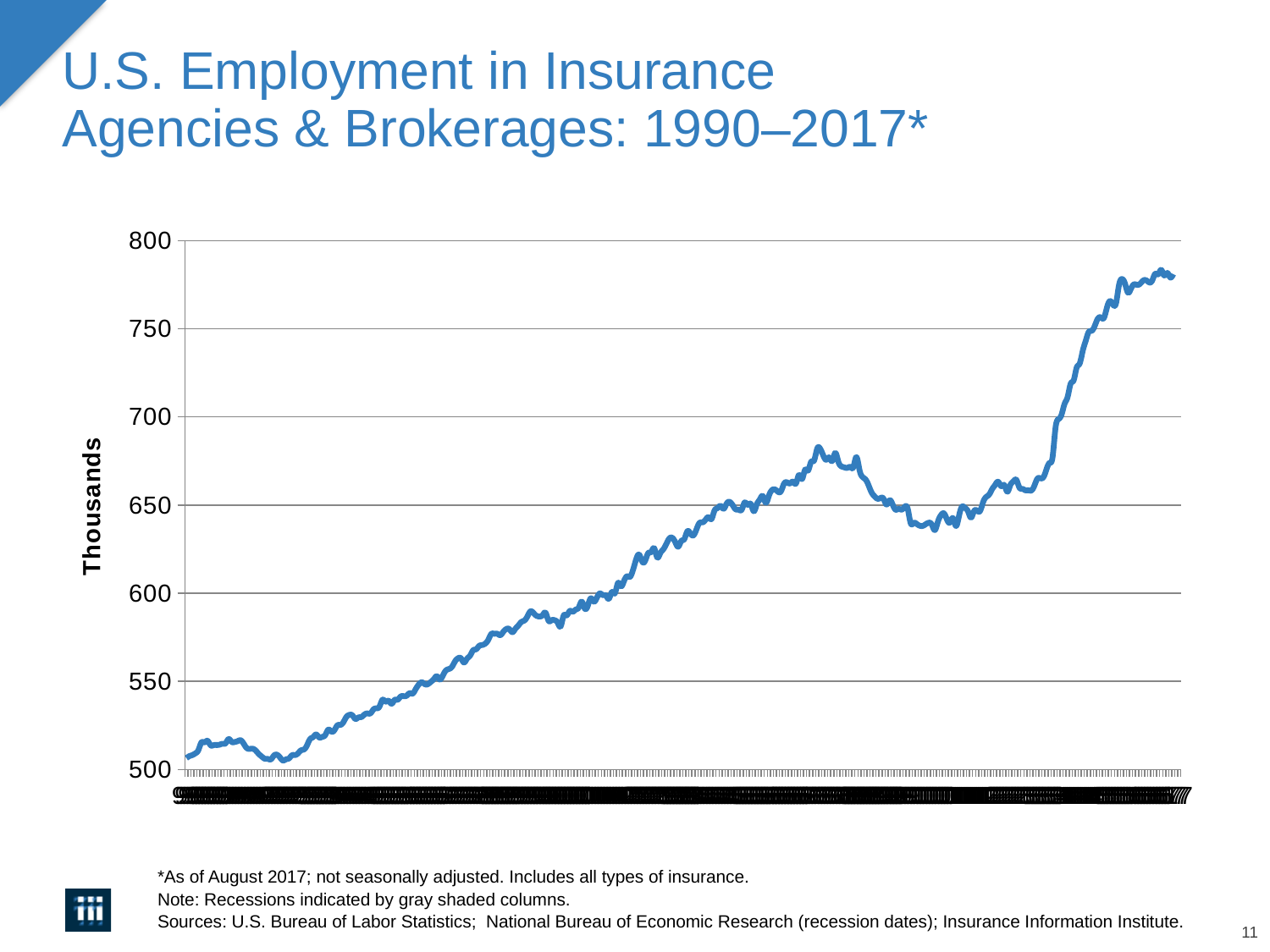
Is the highest value reached by the line greater or less than 750? greater Is the value at the rightmost (ending) point of the line greater or less than 750? greater What is the highest value shown on the vertical axis of the chart? 800 Is the value at the leftmost (starting) point of the line greater or less than 550? less What kind of chart is shown on the slide? line chart What is the title of the chart on the slide? U.S. Employment in Insurance Agencies & Brokerages: 1990–2017* Overall, do the values rise or fall from left to right along the x axis? rise What is the label on the vertical axis of the chart? Thousands Which is larger, the value at the leftmost point of the line or the value at the rightmost point? the rightmost point